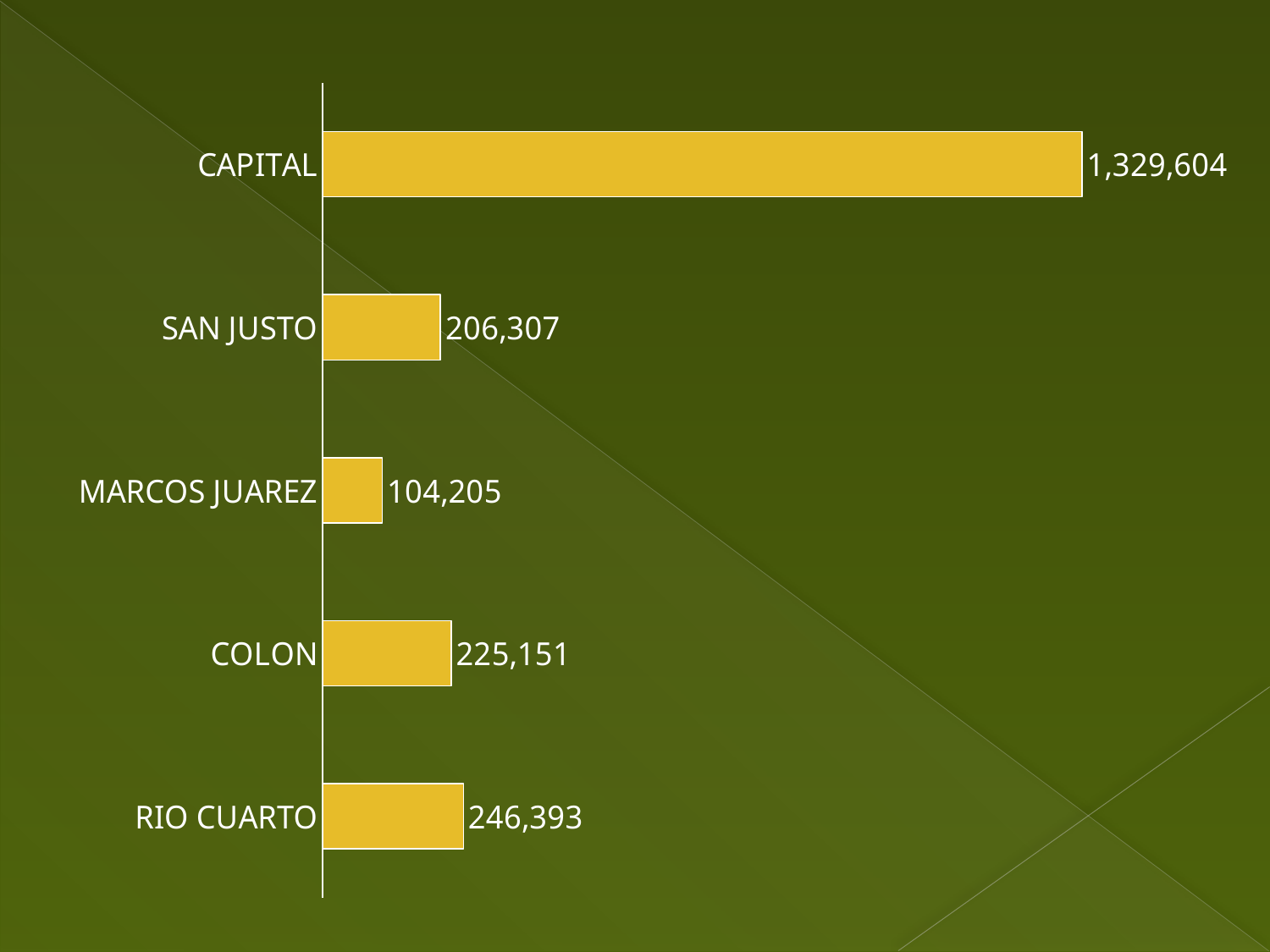
What kind of chart is shown on the slide? Bar chart What is the value for CAPITAL? 1,329,604 What is the value for RIO CUARTO? 246,393 Which is larger, the value for COLON or the value for SAN JUSTO? COLON What is the value for COLON? 225,151 How many categories are shown in the chart? 5 What is the difference between the values for CAPITAL and SAN JUSTO? 1,123,297 What is the value for SAN JUSTO? 206,307 Which category has the lowest value? MARCOS JUAREZ What is the difference between the values for RIO CUARTO and COLON? 21,242 What is the value for MARCOS JUAREZ? 104,205 Which category has the highest value? CAPITAL